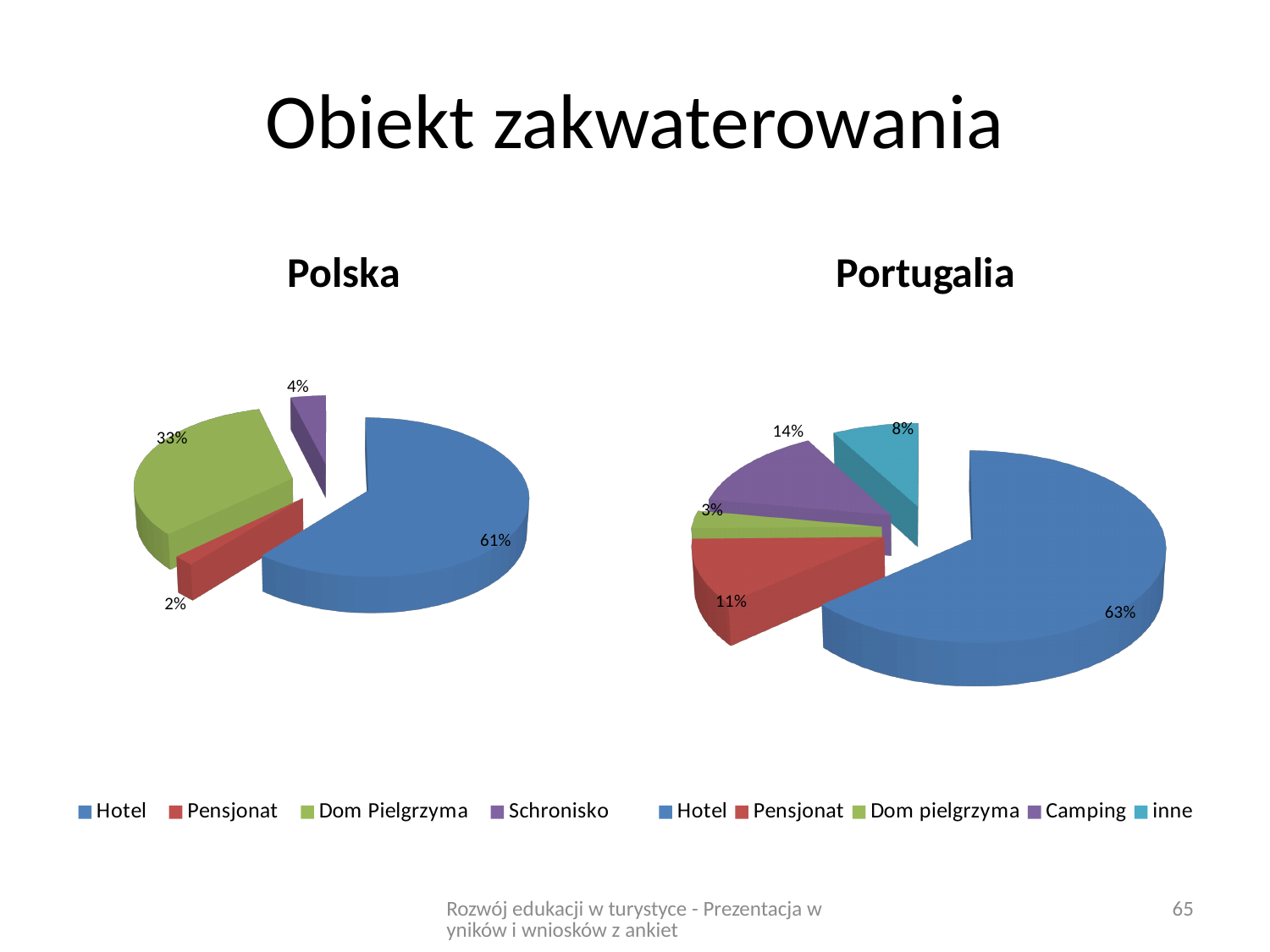
In the Portugalia chart, which category has the smallest share? Dom pielgrzyma How many categories does the Polska chart's legend list? 4 In the Polska chart, what share does Dom Pielgrzyma have? 33% How many categories does the Portugalia chart's legend list? 5 In the Polska chart, which category has the smallest share? Pensjonat Which is larger: the Hotel share in the Polska chart or the Hotel share in the Portugalia chart? Portugalia In the Portugalia chart, which category has the largest share? Hotel What type of chart is the Polska chart? Pie chart In the Portugalia chart, what share does Camping have? 14% In the Polska chart, what is the difference between the Hotel share and the Dom Pielgrzyma share? 28% In the Portugalia chart, what share does Pensjonat have? 11% In the Polska chart, what share does Hotel have? 61%